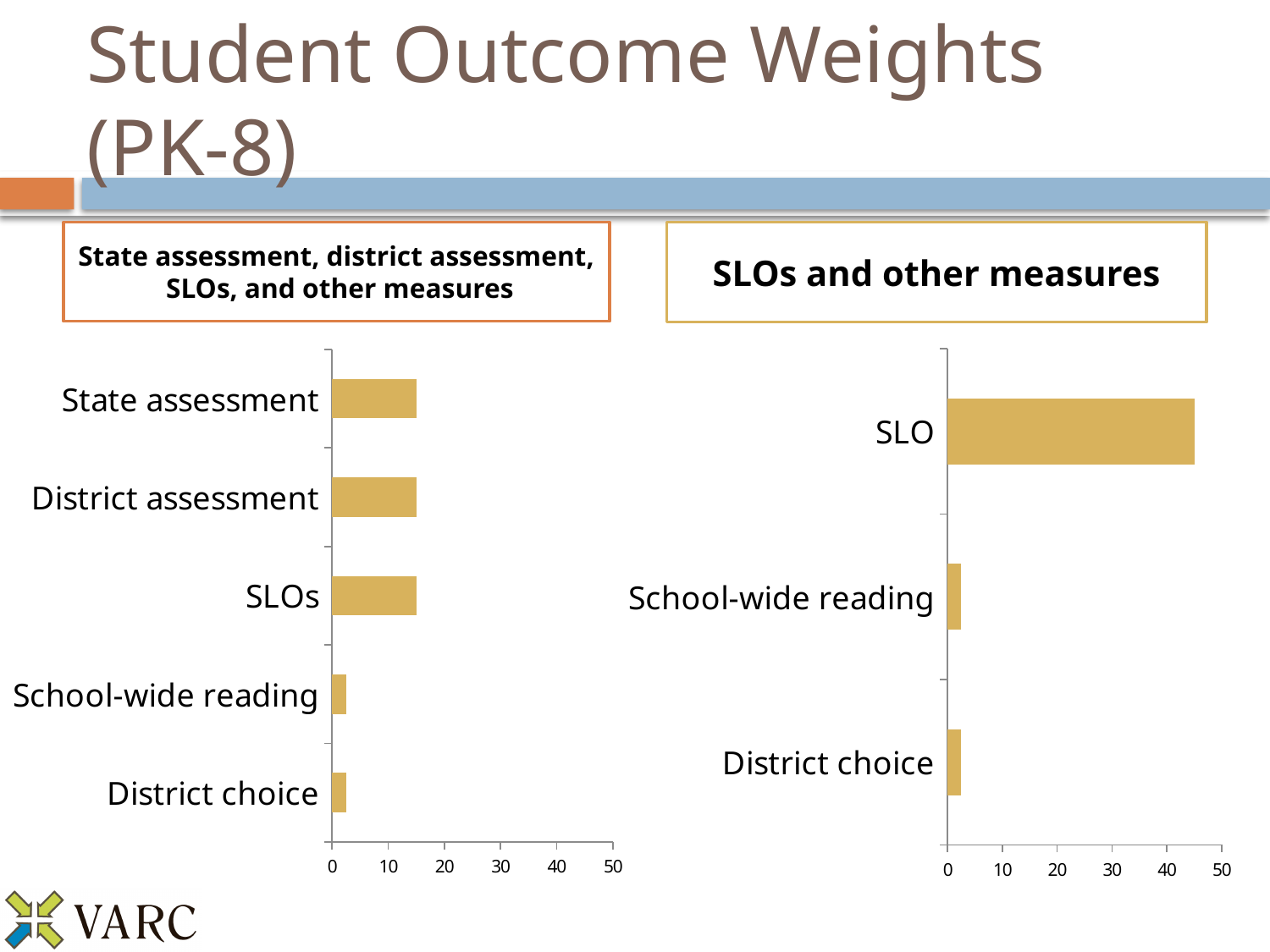
What is the maximum value shown on the x axis of the right chart titled 'SLOs and other measures'? 50 In the left chart titled 'State assessment, district assessment, SLOs, and other measures', is the value for State assessment greater or less than 10? greater In the right chart titled 'SLOs and other measures', which is larger: the value for SLO or the value for School-wide reading? SLO In the right chart titled 'SLOs and other measures', how many categories are plotted? 3 In the left chart titled 'State assessment, district assessment, SLOs, and other measures', how many categories are plotted? 5 What kind of chart is the left chart titled 'State assessment, district assessment, SLOs, and other measures'? Bar chart In the left chart titled 'State assessment, district assessment, SLOs, and other measures', is the value for School-wide reading greater or less than 10? less In the right chart titled 'SLOs and other measures', is the value for SLO greater or less than 40? greater In the left chart titled 'State assessment, district assessment, SLOs, and other measures', which is larger: the value for District assessment or the value for District choice? District assessment In the right chart titled 'SLOs and other measures', which category has the highest value? SLO